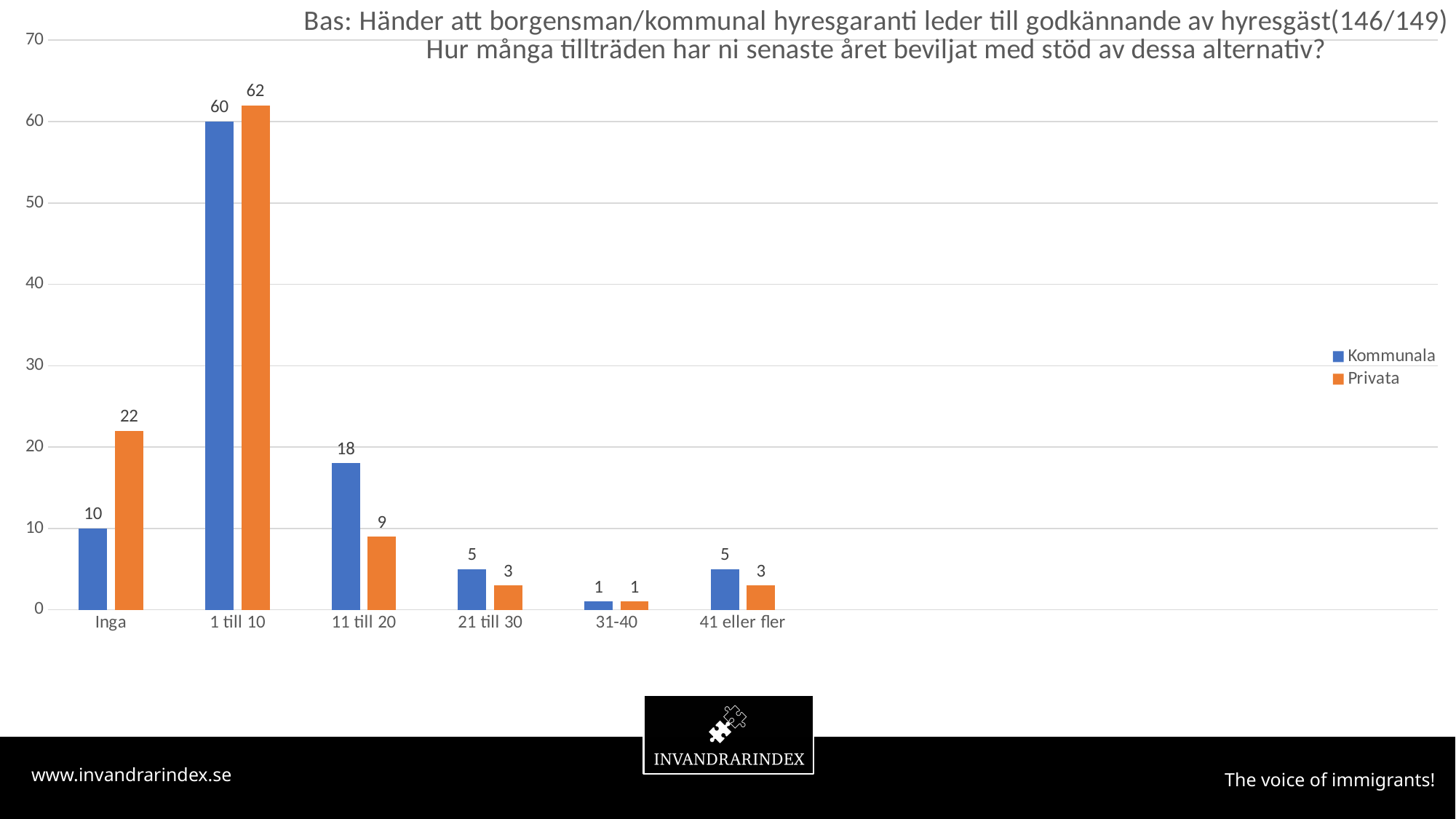
Which is larger for '21 till 30': the Kommunala value or the Privata value? Kommunala What is the Privata value for the category '11 till 20'? 9 Which category has the lowest Kommunala value? 31-40 How many series does the legend list? 2 What is the difference between the Privata and Kommunala values for 'Inga'? 12 What is the Kommunala value for the category '1 till 10'? 60 What is the Privata value for the category 'Inga'? 22 What is the difference between the Kommunala and Privata values for '11 till 20'? 9 Which colour represents the Privata series? Orange How many categories are shown on the x axis? 6 Which category has the highest Privata value? 1 till 10 What kind of chart is shown on the slide? Bar chart